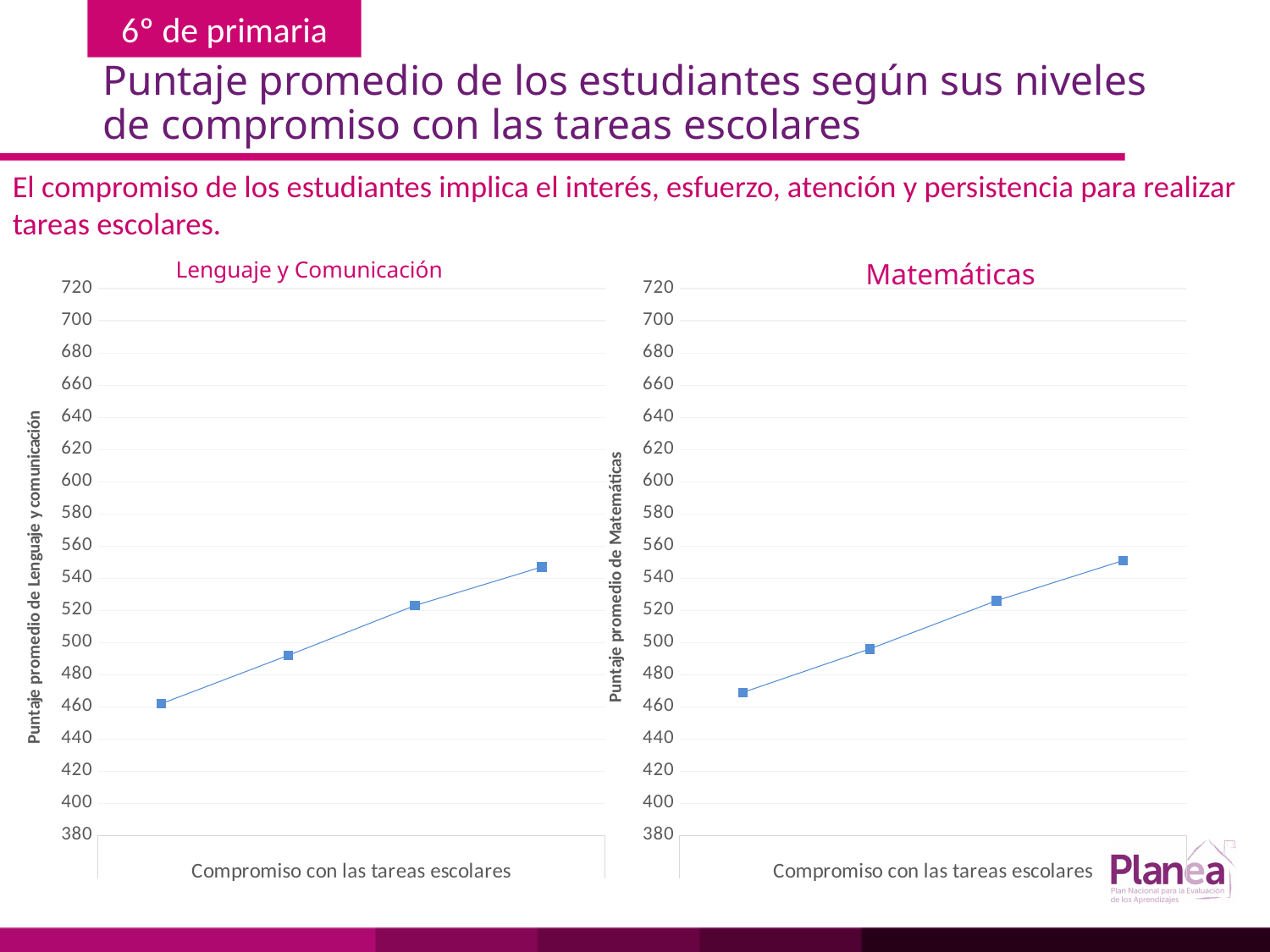
In the Lenguaje y Comunicación chart, how many data points are plotted? 4 In the Lenguaje y Comunicación chart, do the values rise or fall from left to right along the x axis? rise What is the x-axis label of the Lenguaje y Comunicación chart? Compromiso con las tareas escolares What kind of chart is the Lenguaje y Comunicación chart on the left? line chart In the Lenguaje y Comunicación chart, is the value for the last (rightmost) point greater or less than 520? greater In the Matemáticas chart, is the value for the first (leftmost) point greater or less than 480? less In the Lenguaje y Comunicación chart, is the value for the first (leftmost) point greater or less than 480? less What is the title of the chart on the right? Matemáticas In the Matemáticas chart, how many data points are plotted? 4 In the Matemáticas chart, do the values rise or fall from left to right along the x axis? rise